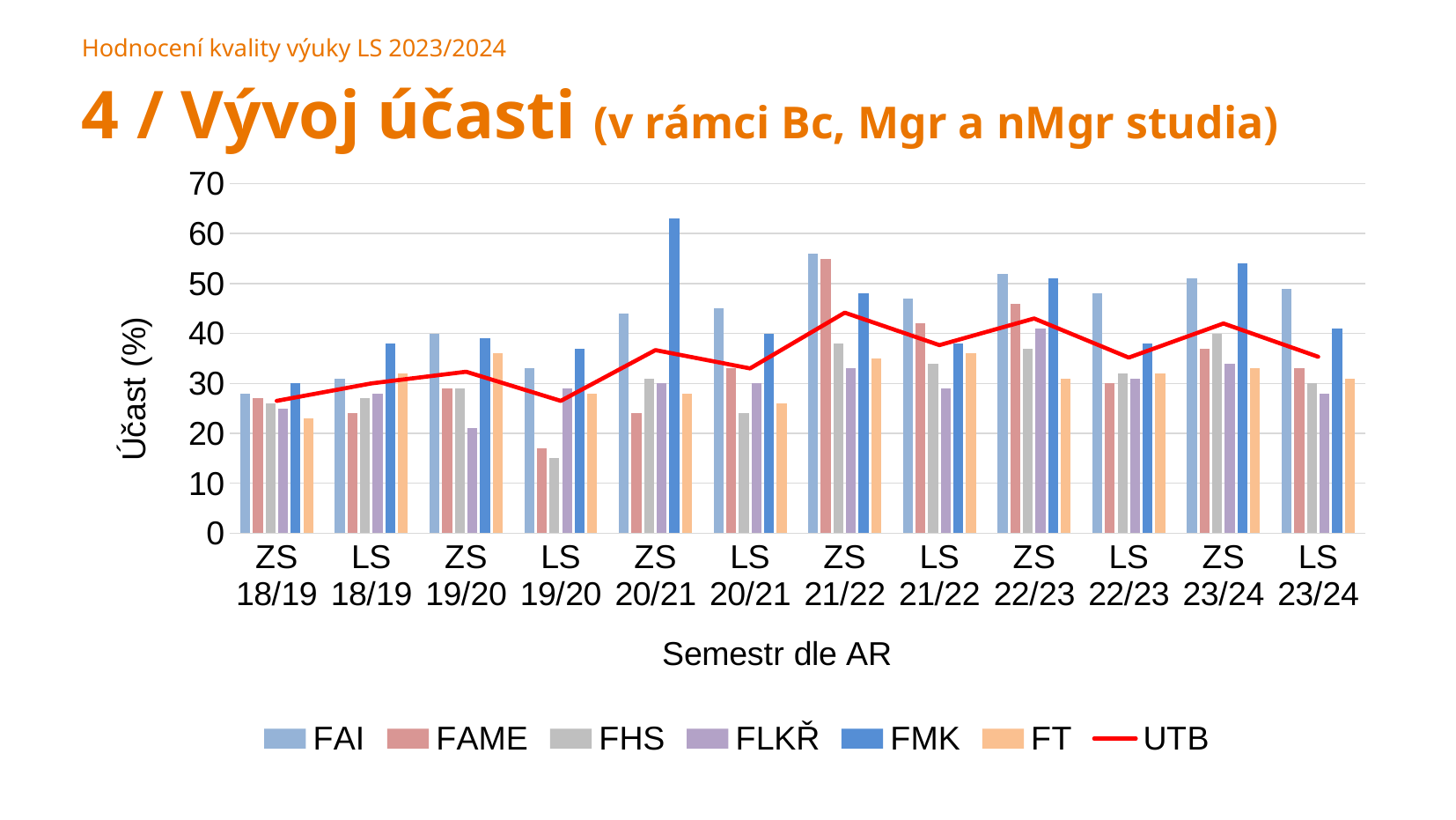
What kind of chart is shown on the slide? bar chart with a line In LS 23/24, which is larger, the value for FAI or the value for FMK? FAI Does the UTB line rise or fall from ZS 18/19 to ZS 21/22? rise Which faculty has the highest participation in ZS 20/21? FMK Is the value for FT in ZS 18/19 greater or less than 30? less Is the value for FMK in ZS 23/24 greater or less than 50? greater Which series is drawn as a red line rather than bars? UTB What is the title of the vertical axis? Účast (%) How many series does the legend list? 7 Is the value for FHS in LS 19/20 greater or less than 20? less How many semesters are shown along the x axis? 12